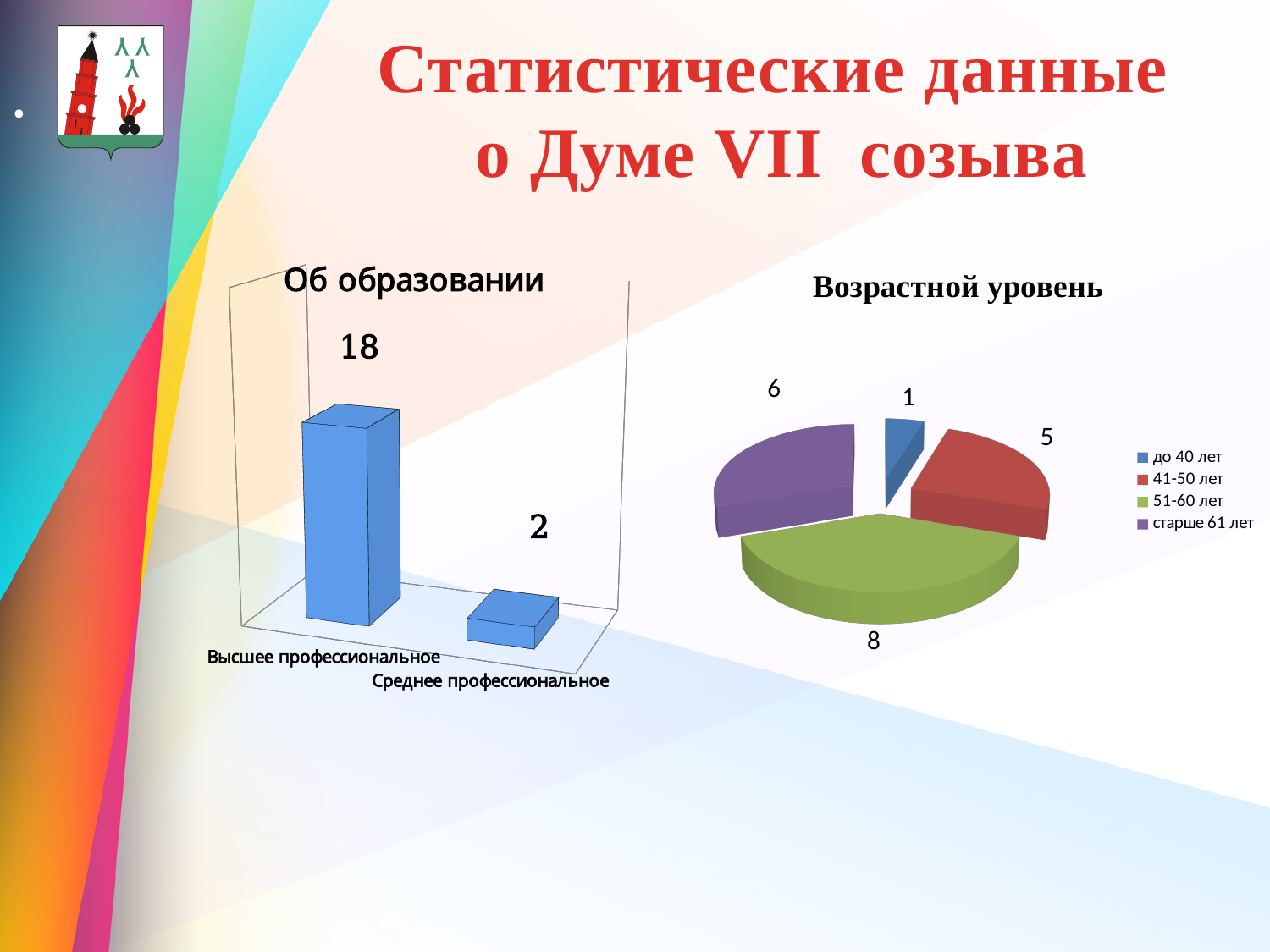
In the 'Об образовании' chart, what is the difference between Высшее профессиональное and Среднее профессиональное? 16 In the 'Об образовании' chart, what is the value for Среднее профессиональное? 2 In the 'Возрастной уровень' chart, which age group has the smallest slice? до 40 лет In the 'Об образовании' chart, what is the value for Высшее профессиональное? 18 How many categories does the 'Об образовании' chart show? 2 In the 'Об образовании' chart, which category has the higher value? Высшее профессиональное In the 'Возрастной уровень' chart, what share of the total does the 51-60 лет slice represent? 40% In the 'Возрастной уровень' chart, which is larger: 41-50 лет or старше 61 лет? старше 61 лет How many entries does the legend of the 'Возрастной уровень' chart list? 4 In the 'Возрастной уровень' chart, what is the value for 51-60 лет? 8 What kind of chart is the 'Об образовании' chart? Bar chart In the 'Возрастной уровень' chart, what is the value for до 40 лет? 1